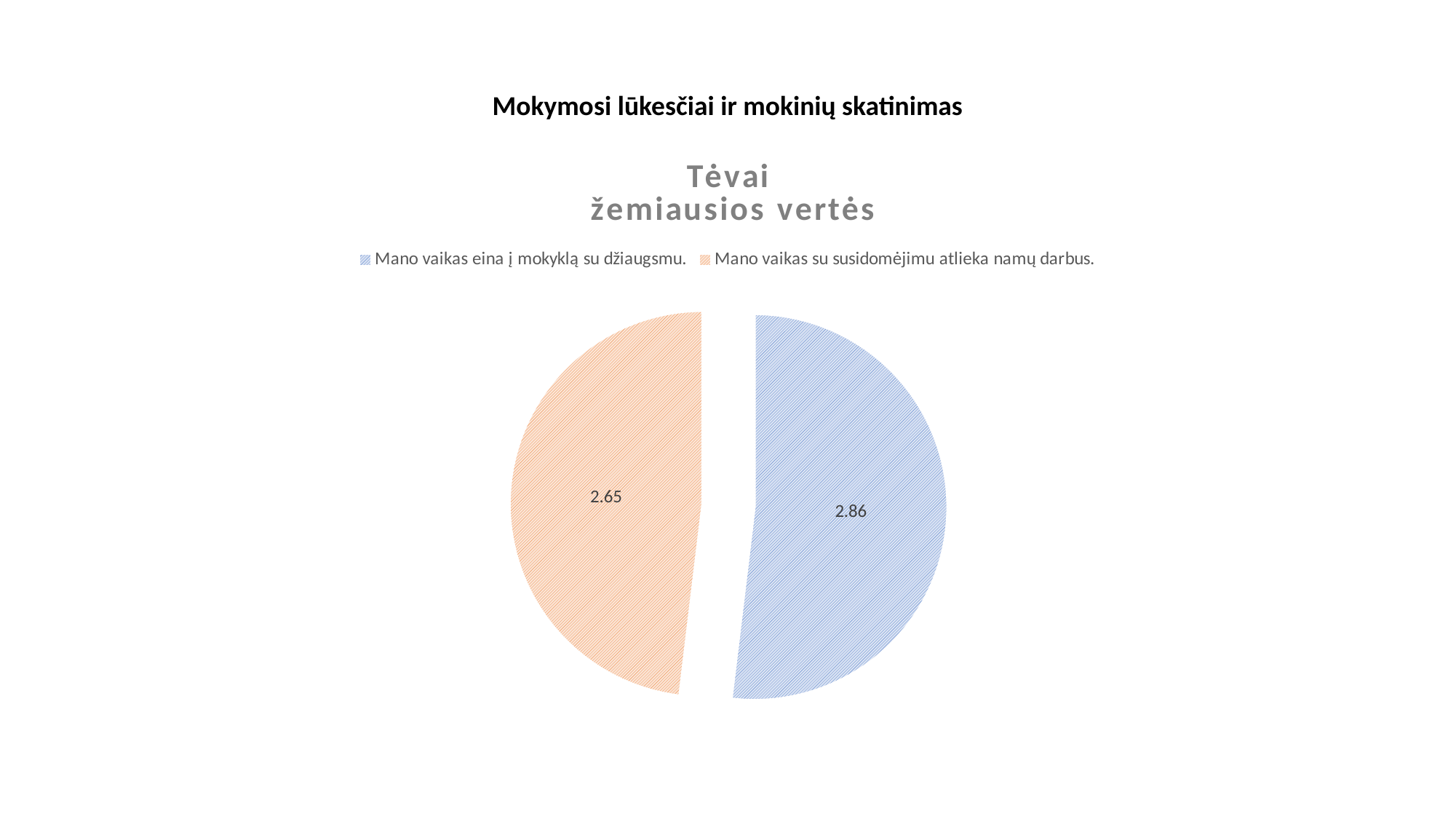
Which category has the lowest value? Mano vaikas su susidomėjimu atlieka namų darbus. What is the sum of the two values shown in the pie chart? 5.51 How many slices does the pie chart have? 2 How many entries does the legend list? 2 What kind of chart is shown on the slide? pie chart What is the difference between the values for "Mano vaikas eina į mokyklą su džiaugsmu." and "Mano vaikas su susidomėjimu atlieka namų darbus."? 0.21 Which is larger: the value for "Mano vaikas eina į mokyklą su džiaugsmu." or the value for "Mano vaikas su susidomėjimu atlieka namų darbus."? Mano vaikas eina į mokyklą su džiaugsmu. What is the value for "Mano vaikas su susidomėjimu atlieka namų darbus."? 2.65 What is the value for "Mano vaikas eina į mokyklą su džiaugsmu."? 2.86 Which category has the highest value? Mano vaikas eina į mokyklą su džiaugsmu. Which colour represents "Mano vaikas su susidomėjimu atlieka namų darbus." in the chart? orange What is the title of the chart? Tėvai žemiausios vertės